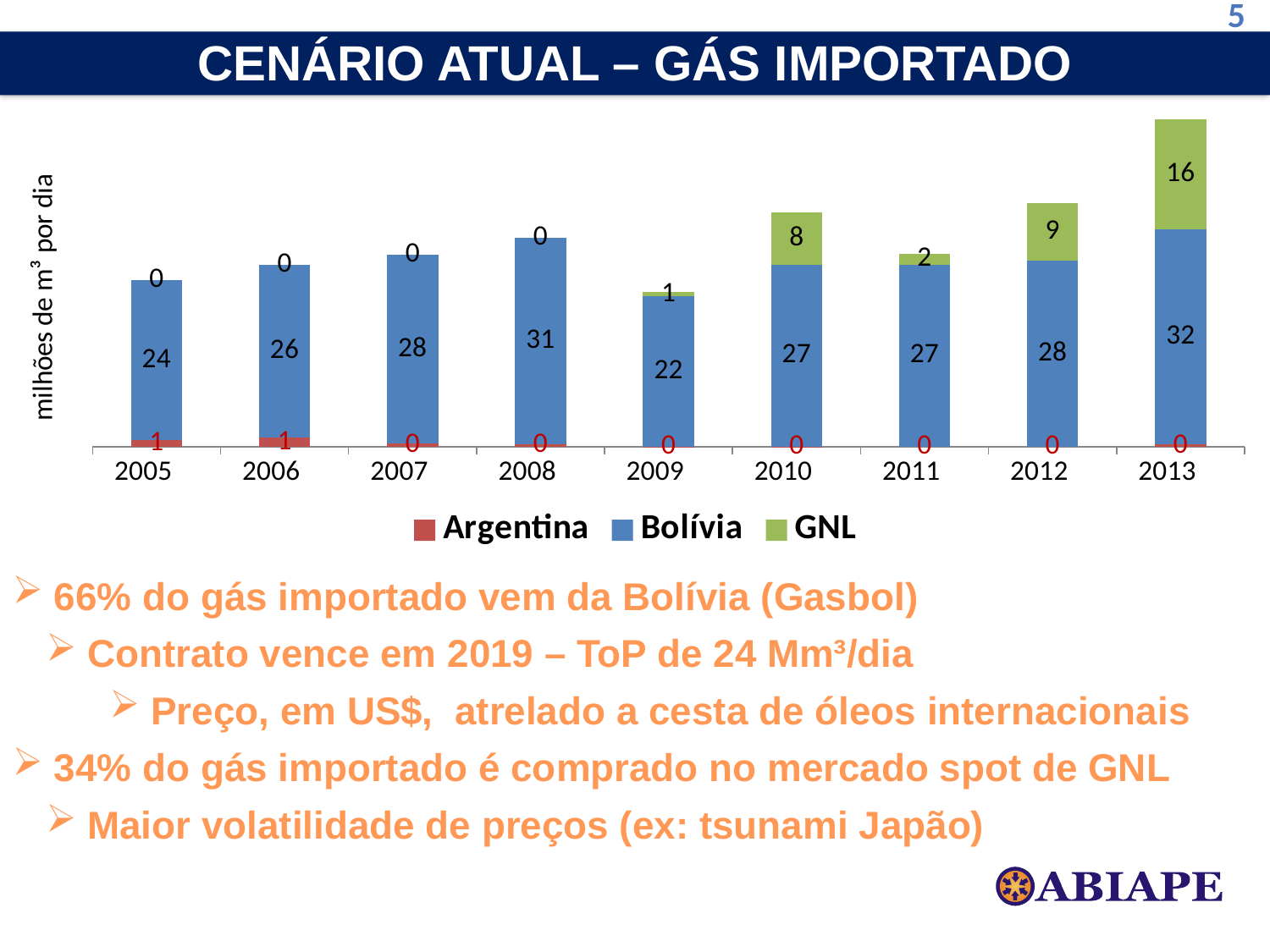
What is the total of the stacked bar for 2013? 48 What is the difference between the Bolívia values for 2013 and 2009? 10 Which is larger, the GNL value for 2012 or the GNL value for 2011? 2012 What is the Bolívia value for 2013? 32 What is the y-axis label of the chart? milhões de m³ por dia What is the Argentina value for 2006? 1 In which year is the GNL value highest? 2013 What is the GNL value for 2010? 8 In which year is the Bolívia value lowest? 2009 How many series does the legend list? 3 What kind of chart is shown on the slide? stacked bar chart How many years are shown on the x axis? 9